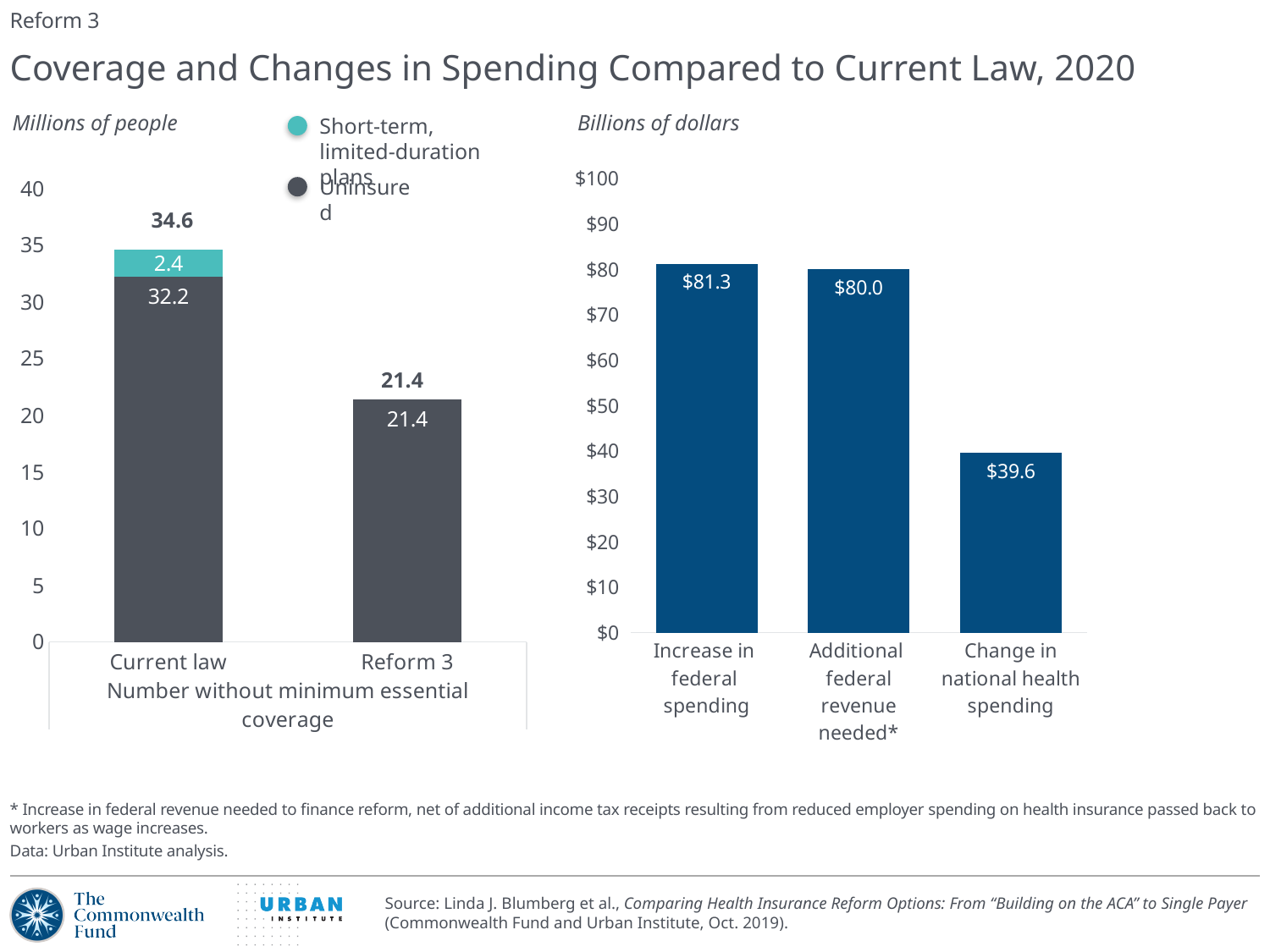
In the left chart (Millions of people), what is the uninsured value for Current law? 32.2 In the right chart (Billions of dollars), what is the value for Change in national health spending? $39.6 In the left chart (Millions of people), what is the difference between the Current law total and the Reform 3 total? 13.2 In the right chart (Billions of dollars), which category has the lowest value? Change in national health spending In the right chart (Billions of dollars), what is the difference between Increase in federal spending and Change in national health spending? $41.7 In the left chart (Millions of people), what is the total for Reform 3? 21.4 In the right chart (Billions of dollars), how many categories are shown? 3 In the left chart (Millions of people), what is the value for short-term, limited-duration plans under Current law? 2.4 In the left chart (Millions of people), what is the total of the stacked bar for Current law? 34.6 In the left chart (Millions of people), how many series does the legend list? 2 What kind of chart is the right chart (Billions of dollars)? Bar chart In the right chart (Billions of dollars), what is the value for Increase in federal spending? $81.3